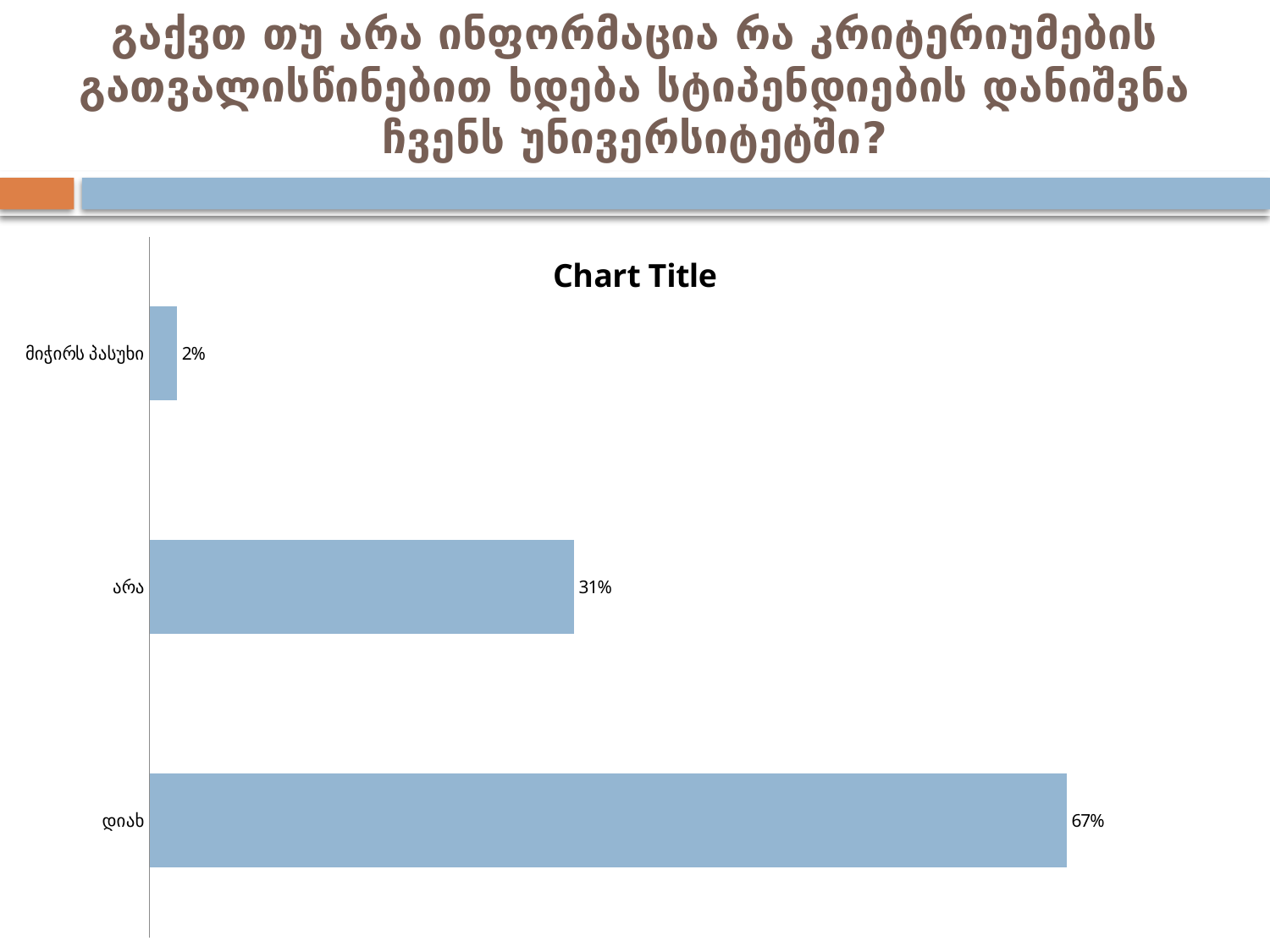
How many categories are shown in the chart? 3 What is the title shown above the chart? Chart Title Which is larger, the value for არა or the value for მიჭირს პასუხი? არა What is the value for არა? 31% Which category has the lowest value? მიჭირს პასუხი What is the value for დიახ? 67% What kind of chart is shown on the slide? Bar chart What is the difference between the values for არა and მიჭირს პასუხი? 29% What is the total of the three values shown in the chart? 100% Which category has the highest value? დიახ What is the difference between the values for დიახ and არა? 36% What is the value for მიჭირს პასუხი? 2%